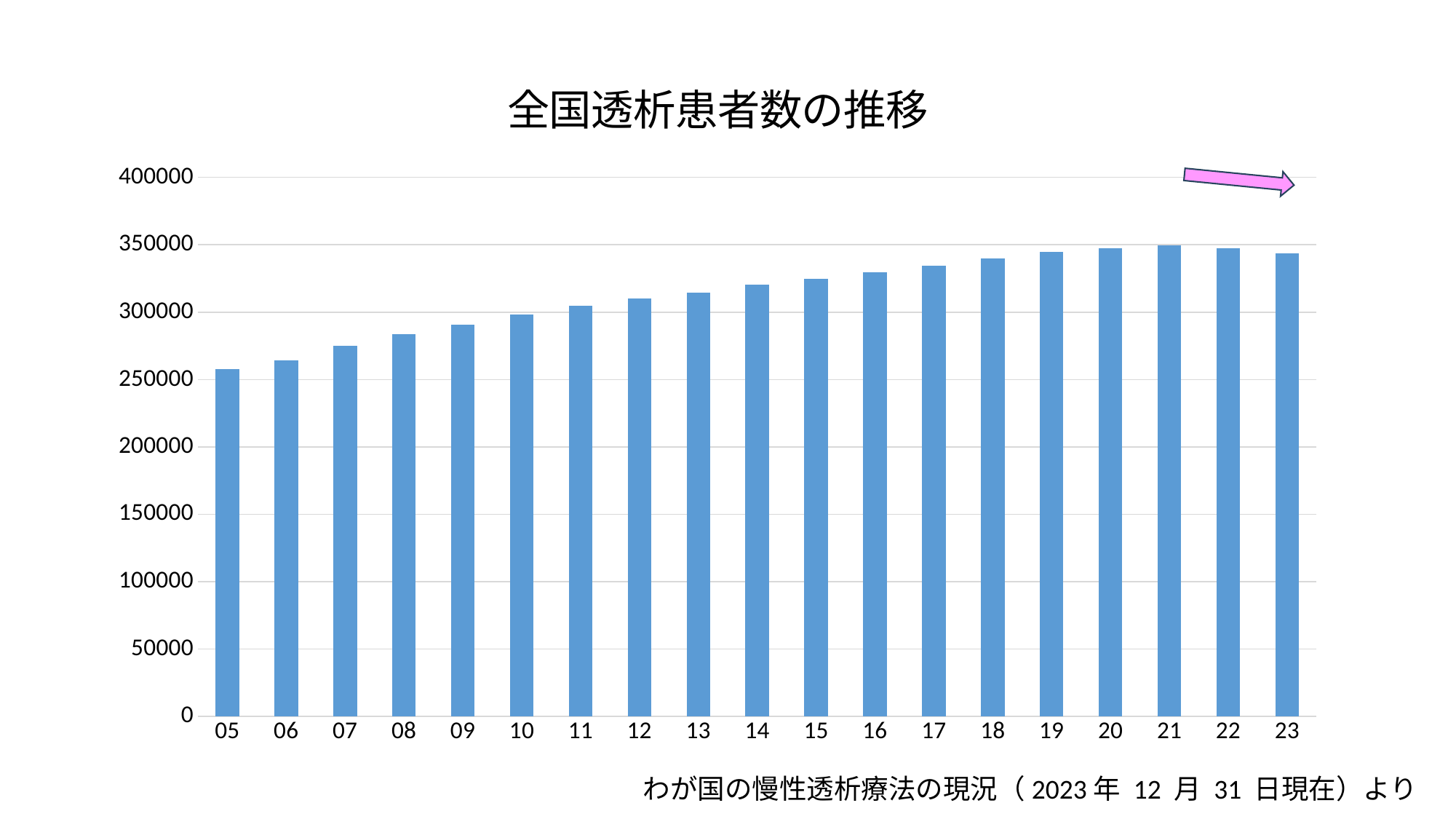
Is the value for 23 greater or less than 350000? less What colour are the bars in the chart? blue Is the value for 05 greater or less than 250000? greater Which is larger, the value for 10 or the value for 15? 15 How many bars (years) are plotted in the chart? 19 Which year has the lowest value in the chart? 05 Which is larger, the value for 05 or the value for 23? 23 What kind of chart is shown on the slide? bar chart Is the value for 09 greater or less than 300000? less Do the values generally rise or fall from 05 to 20 along the x axis? rise What is the title of the chart? 全国透析患者数の推移